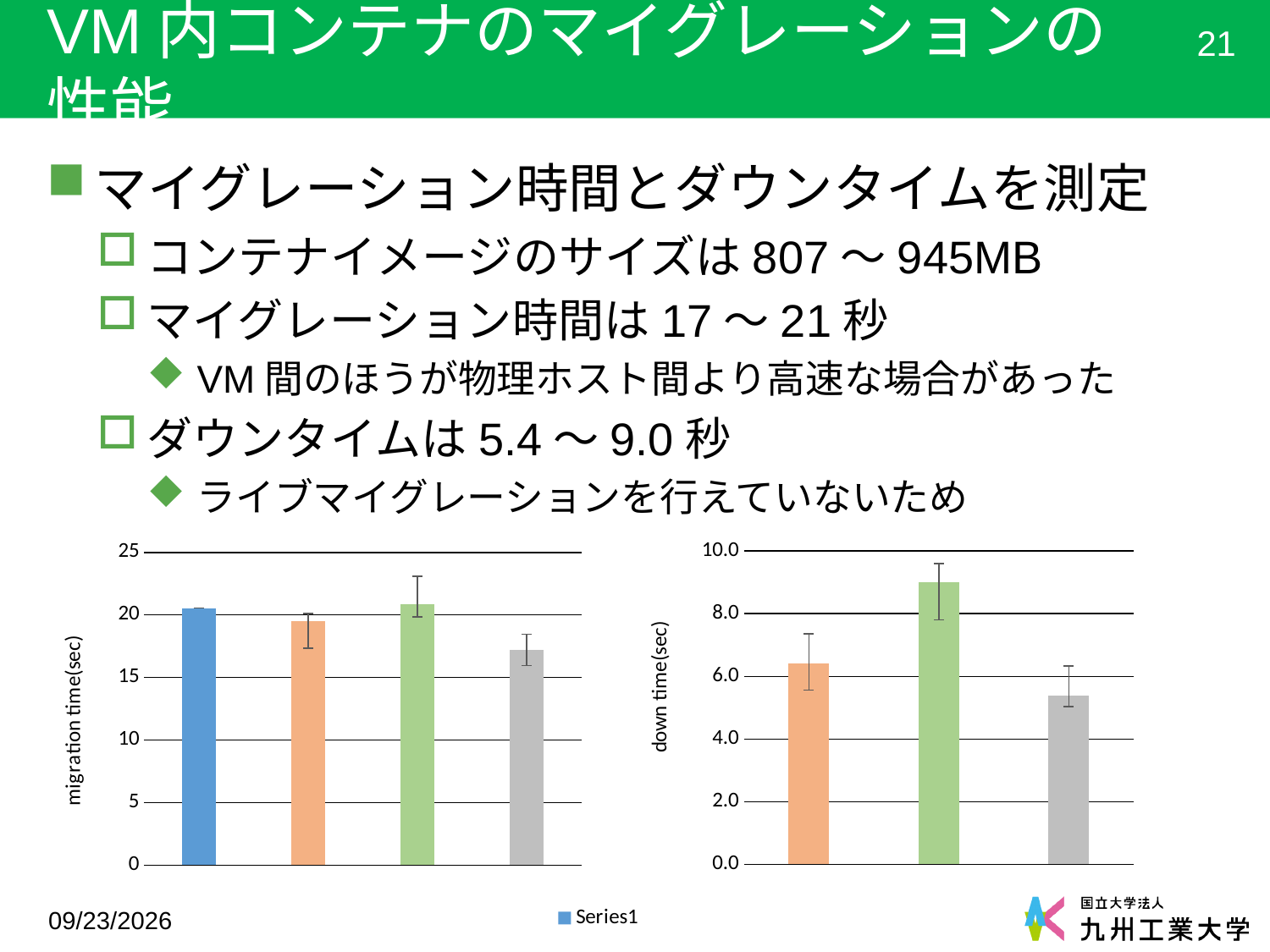
How many series does the legend below the left chart list? 1 In the right chart (down time), which bar is the highest? the green bar (second bar) How many bars are plotted in the left chart (migration time)? 4 What kind of chart is the left chart (migration time)? bar chart In the right chart (down time), is the value of the green (second) bar greater or less than 8.0? greater In the left chart (migration time), is the value of the gray (fourth) bar greater or less than 20? less In the right chart (down time), is the value of the gray (third) bar greater or less than 6.0? less How many bars are plotted in the right chart (down time)? 3 In the left chart (migration time), which bar is the lowest? the gray bar (fourth bar) What is the y-axis label of the left chart? migration time(sec) What is the y-axis label of the right chart? down time(sec)